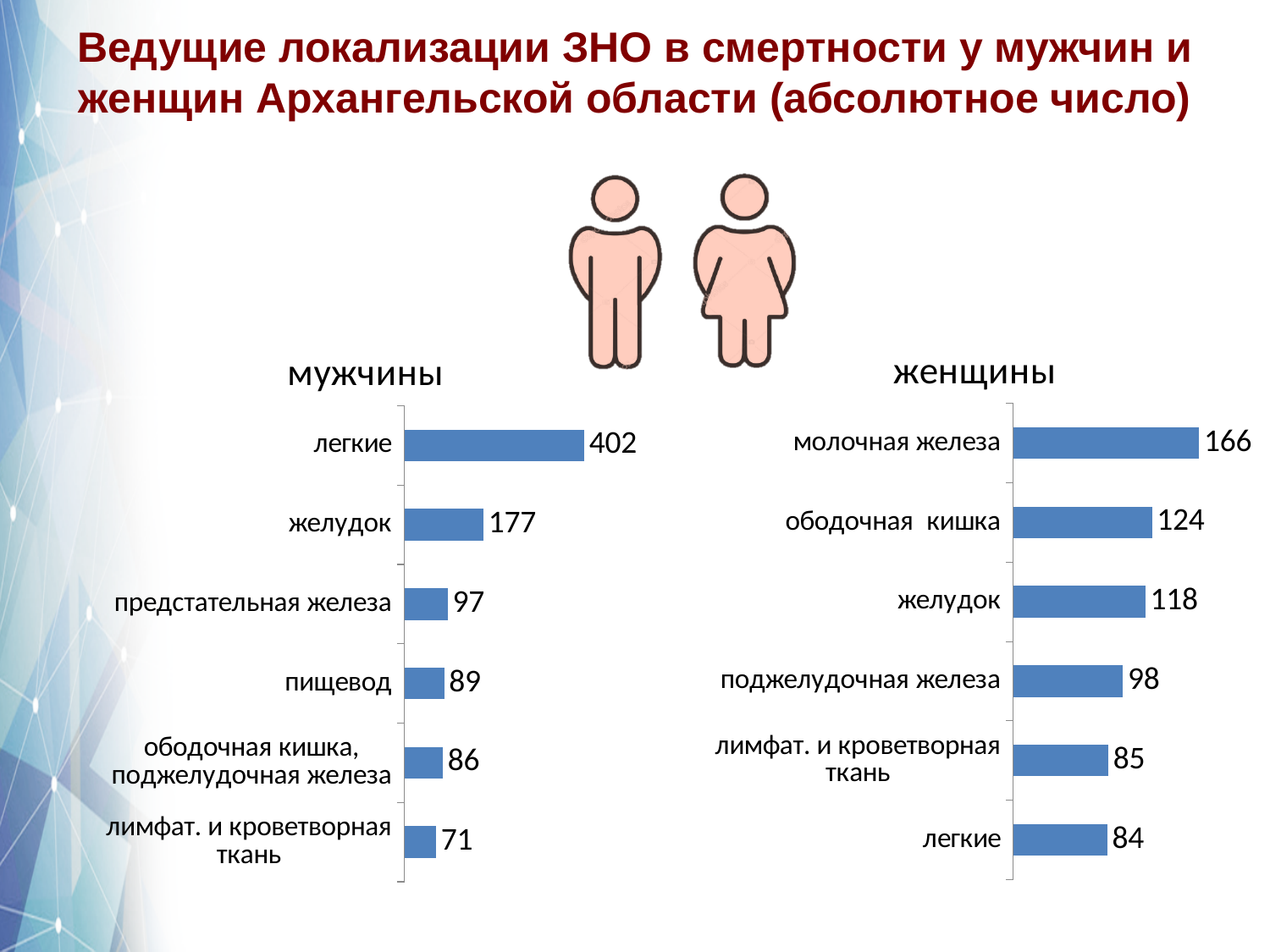
In the 'мужчины' chart, what is the value for 'пищевод'? 89 What type of chart is the 'женщины' chart? bar chart In the 'женщины' chart, what is the value for 'желудок'? 118 Which is larger: the value for 'желудок' in the 'мужчины' chart or the value for 'желудок' in the 'женщины' chart? мужчины In the 'мужчины' chart, which category has the lowest value? лимфат. и кроветворная ткань In the 'женщины' chart, which category has the highest value? молочная железа How many categories are shown in the 'мужчины' chart? 6 In the 'женщины' chart, which is larger: 'поджелудочная железа' or 'легкие'? поджелудочная железа In the 'мужчины' chart, what is the value for 'легкие'? 402 How many categories are shown in the 'женщины' chart? 6 In the 'мужчины' chart, what is the difference between the values for 'легкие' and 'желудок'? 225 In the 'женщины' chart, what is the difference between the values for 'молочная железа' and 'ободочная кишка'? 42